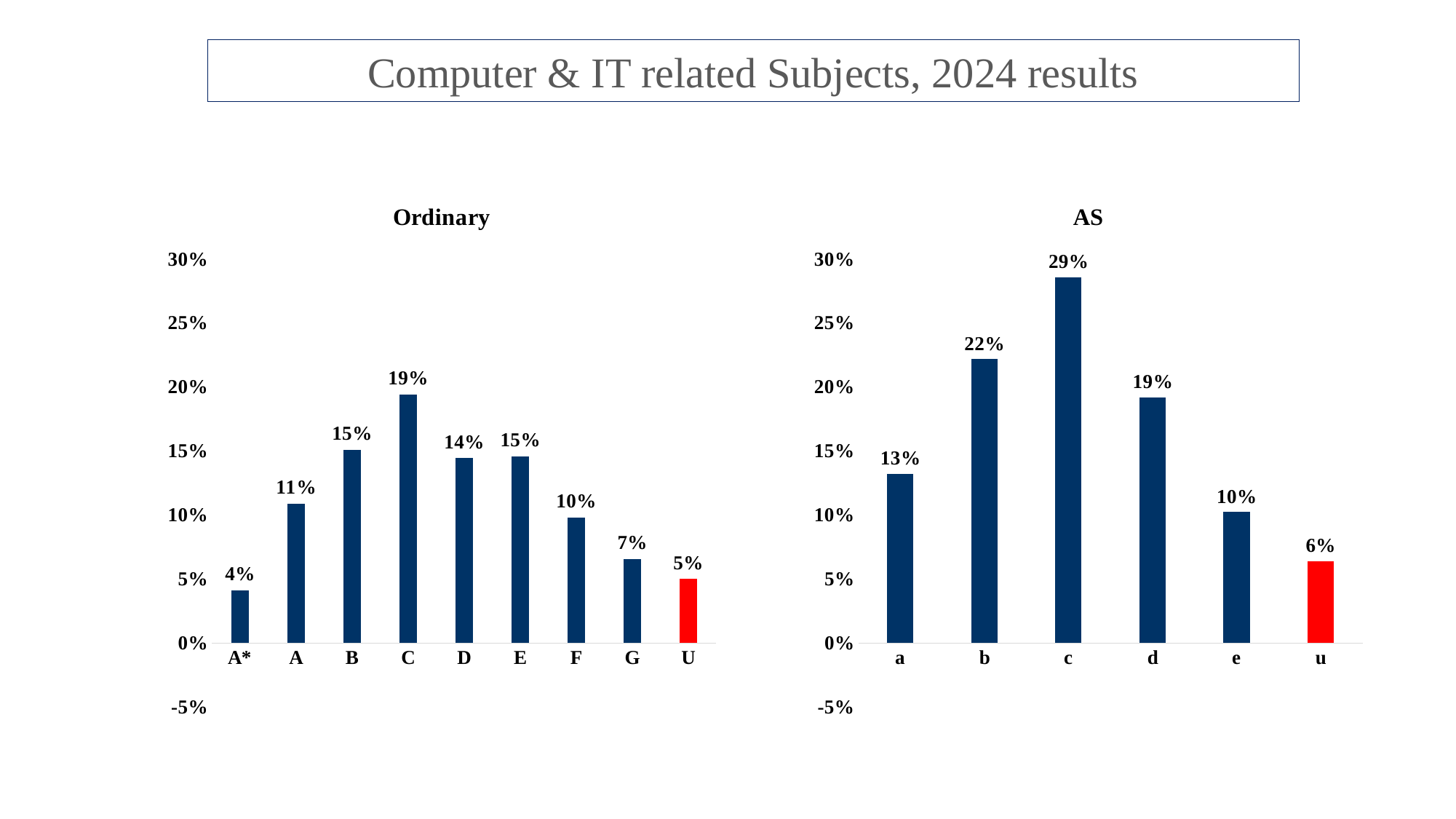
In the AS chart, which bar is coloured red? u In the Ordinary chart, which is larger, the value for A or the value for F? A In the Ordinary chart, what is the value for grade C? 19% In the AS chart, what is the value for grade b? 22% In the Ordinary chart, what is the difference between the values for C and G? 12% What kind of chart is the AS chart? Bar chart In the Ordinary chart, what is the value for grade U? 5% In the Ordinary chart, which grade has the highest value? C How many grade categories are shown in the Ordinary chart? 9 In the AS chart, which grade has the lowest value? u In the AS chart, what is the difference between the values for c and a? 16% How many grade categories are shown in the AS chart? 6